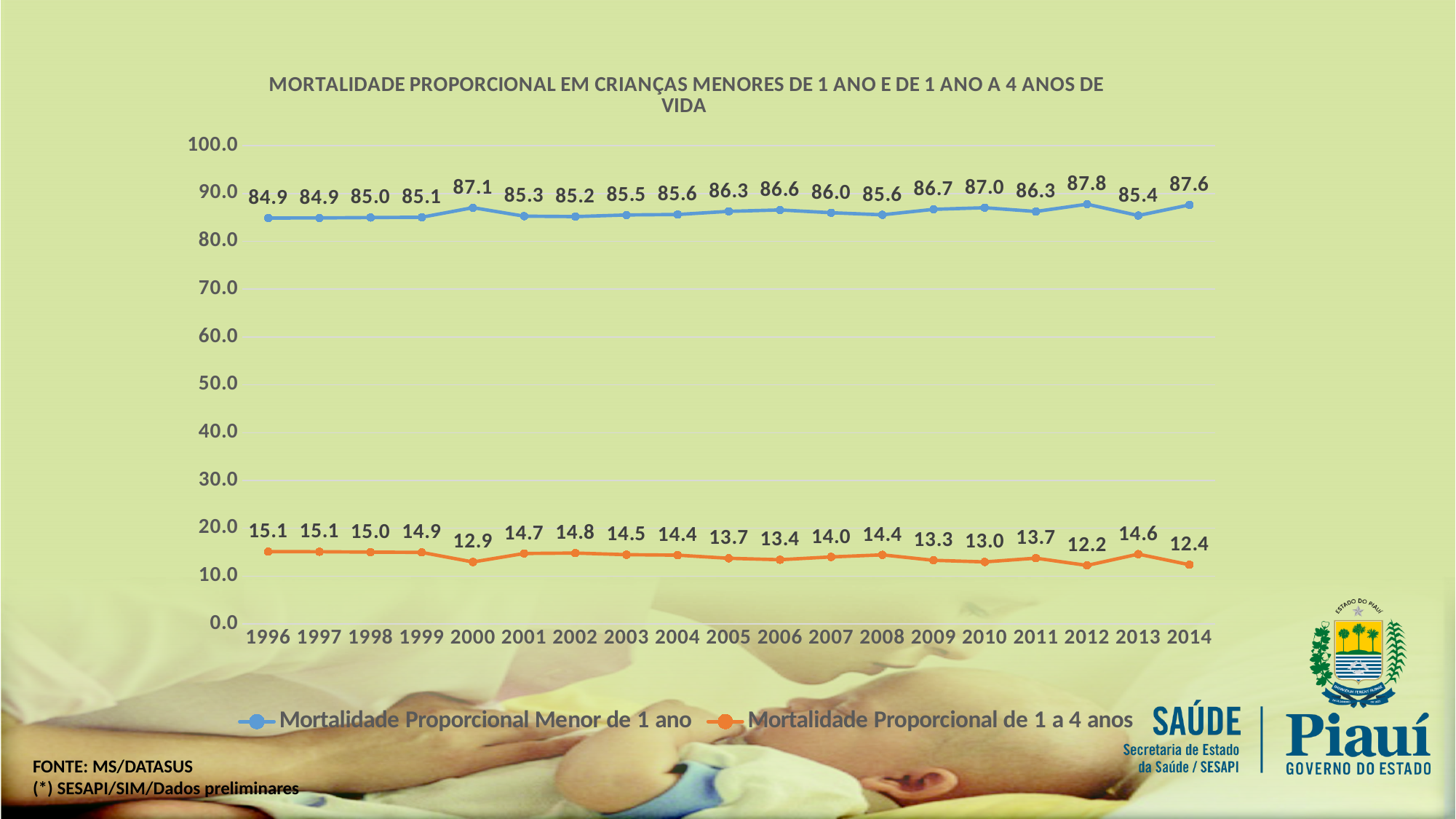
In which year is Mortalidade Proporcional de 1 a 4 anos lowest? 2012 What is the value of Mortalidade Proporcional Menor de 1 ano in 2000? 87.1 Which is larger for Mortalidade Proporcional Menor de 1 ano: the value in 2012 or the value in 2013? 2012 What is the value of Mortalidade Proporcional de 1 a 4 anos in 2014? 12.4 What is the value of Mortalidade Proporcional de 1 a 4 anos in 2008? 14.4 Which colour is used for the Mortalidade Proporcional de 1 a 4 anos series? Orange What is the difference between Mortalidade Proporcional Menor de 1 ano and Mortalidade Proporcional de 1 a 4 anos in 2014? 75.2 What is the difference between the Mortalidade Proporcional de 1 a 4 anos values in 1996 and 2000? 2.2 What kind of chart is shown on the slide? Line chart In which year is Mortalidade Proporcional Menor de 1 ano highest? 2012 How many years are shown on the x axis? 19 How many series does the legend list? 2